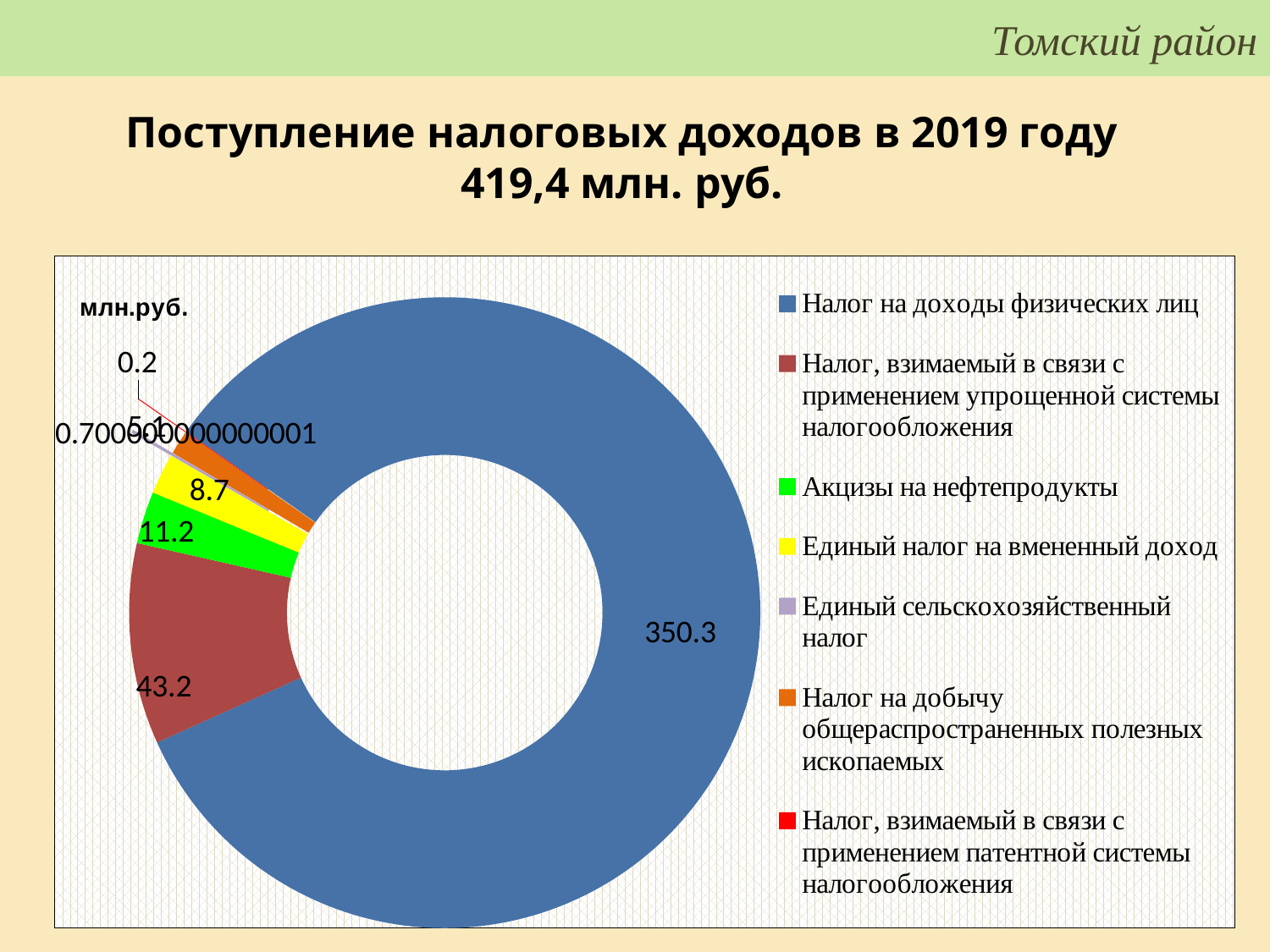
What kind of chart is shown? Doughnut (pie) chart What is the value for Единый налог на вмененный доход? 8.7 What is the value for Налог, взимаемый в связи с применением патентной системы налогообложения? 0.2 How many categories does the legend list? 7 Which category has the largest value? Налог на доходы физических лиц What unit is shown in the top-left corner of the chart? млн.руб. What is the value for Налог на доходы физических лиц? 350.3 What is the value for Акцизы на нефтепродукты? 11.2 Which is larger: Акцизы на нефтепродукты or Единый налог на вмененный доход? Акцизы на нефтепродукты What is the value for Налог, взимаемый в связи с применением упрощенной системы налогообложения? 43.2 What is the difference between the values for Налог, взимаемый в связи с применением упрощенной системы налогообложения and Акцизы на нефтепродукты? 32.0